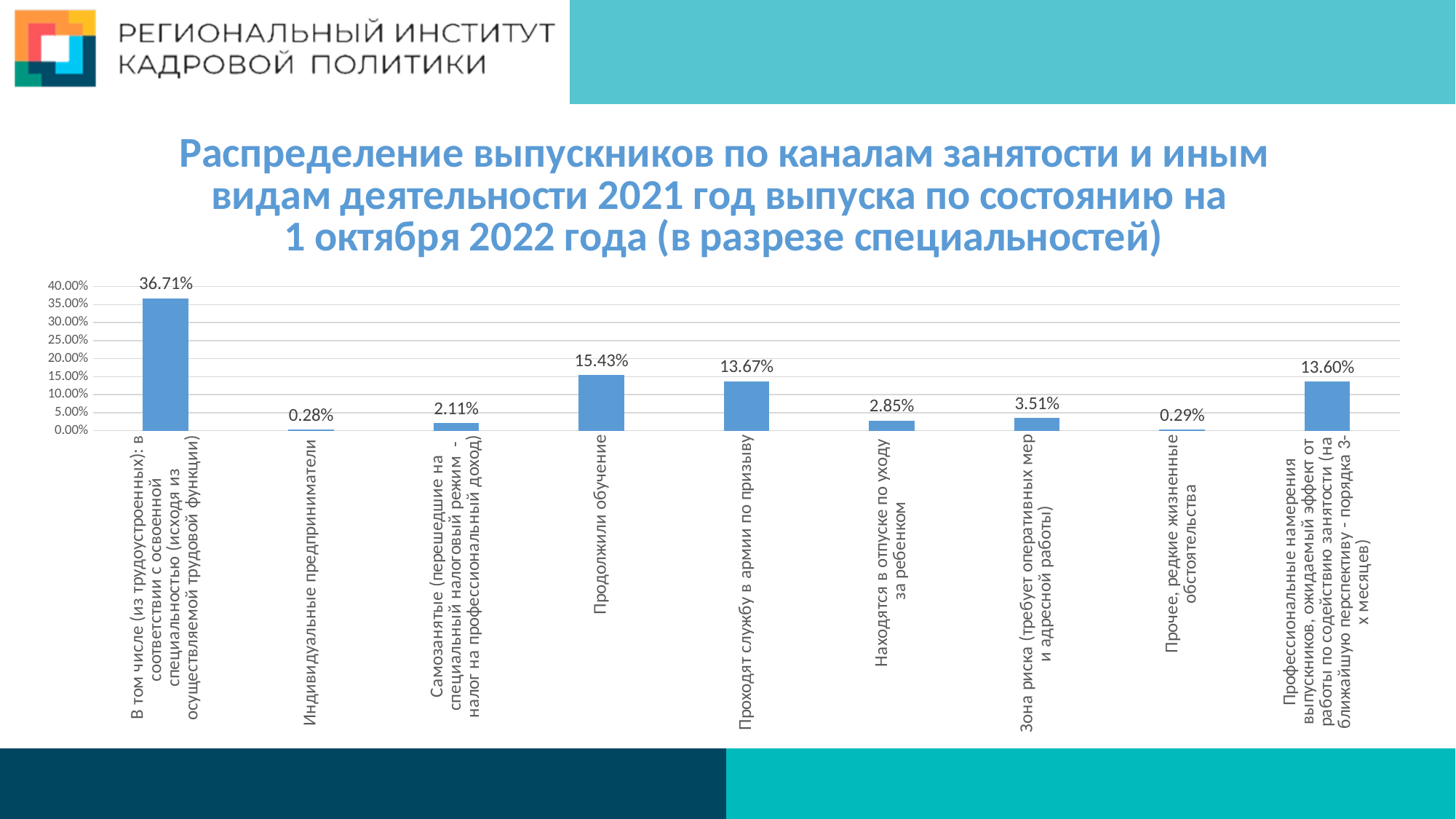
What is the value for «Продолжили обучение»? 15.43% How many categories are shown on the x axis? 9 Which is larger: the value for «Продолжили обучение» or for «Профессиональные намерения выпускников»? Продолжили обучение What kind of chart is shown on the slide? bar chart Is the value for «Самозанятые» greater or less than 5.00%? less What is the difference between the values for «Продолжили обучение» and «Проходят службу в армии по призыву»? 1.76% What is the difference between the values for «Зона риска» and «Находятся в отпуске по уходу за ребенком»? 0.66% What is the value for «Зона риска (требует оперативных мер и адресной работы)»? 3.51% Which category has the highest value? В том числе (из трудоустроенных): в соответствии с освоенной специальностью (исходя из осуществляемой трудовой функции) What is the value for «Находятся в отпуске по уходу за ребенком»? 2.85% What is the value for «Индивидуальные предприниматели»? 0.28% What is the value for «Проходят службу в армии по призыву»? 13.67%